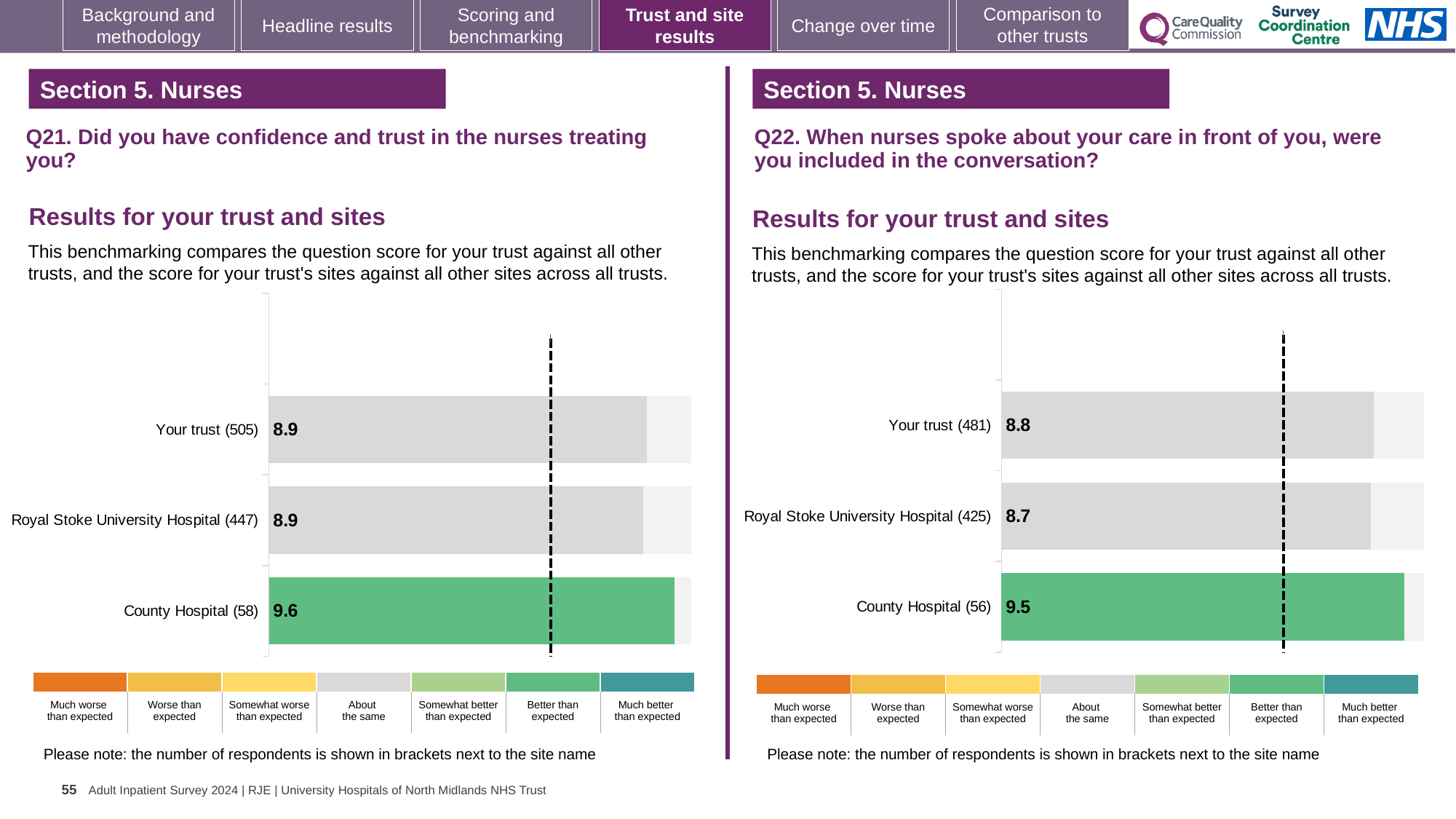
On the Q21 chart (left), what is the score for Your trust (505)? 8.9 On the Q21 chart (left), what is the difference between the County Hospital (58) score and the Your trust (505) score? 0.7 On the Q21 chart (left), which has the larger score: Royal Stoke University Hospital (447) or County Hospital (58)? County Hospital (58) On the Q22 chart (right), which site or trust has the highest score? County Hospital (56) What type of chart is used on the Q22 chart (right)? Bar chart On the Q22 chart (right), what is the score for Royal Stoke University Hospital (425)? 8.7 How many bars are plotted on the Q21 chart (left)? 3 On the Q22 chart (right), which site or trust has the lowest score? Royal Stoke University Hospital (425) On the Q22 chart (right), what is the difference between the County Hospital (56) score and the Royal Stoke University Hospital (425) score? 0.8 On the Q21 chart (left), which bar is coloured green? County Hospital (58) On the Q21 chart (left), what is the score for County Hospital (58)? 9.6 On the Q22 chart (right), what is the score for County Hospital (56)? 9.5